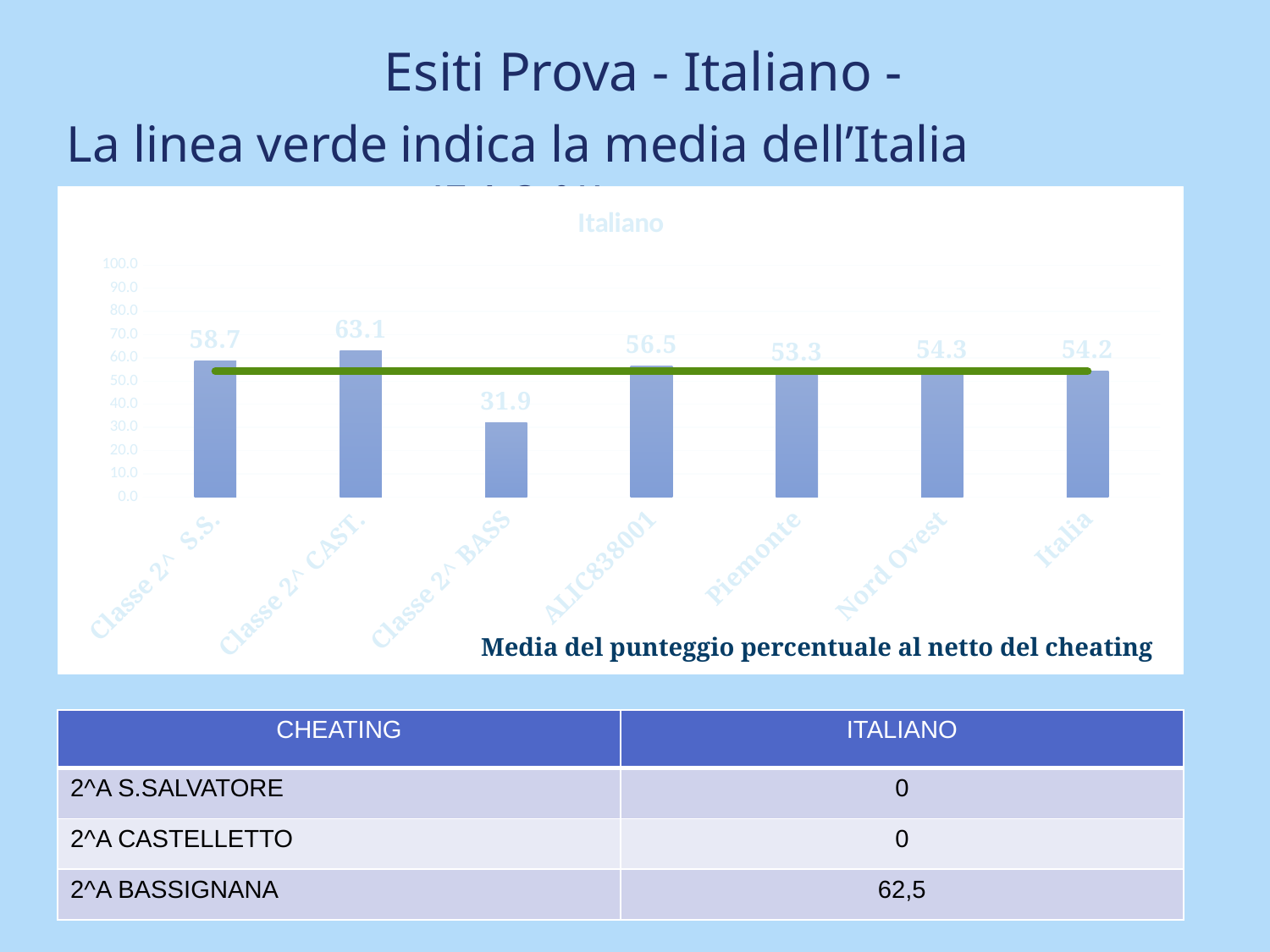
Which is larger in the Italiano chart, the value for Classe 2^ S.S. or the value for ALIC838001? Classe 2^ S.S. What is the value for Piemonte in the Italiano chart? 53.3 How many categories are shown in the Italiano chart? 7 What is the difference between the values for Classe 2^ S.S. and Italia in the Italiano chart? 4.5 Which category has the highest value in the Italiano chart? Classe 2^ CAST. Which category has the lowest value in the Italiano chart? Classe 2^ BASS What is the value for Classe 2^ BASS in the Italiano chart? 31.9 What is the value for Classe 2^ CAST. in the Italiano chart? 63.1 What is the difference between the values for Classe 2^ CAST. and Classe 2^ BASS in the Italiano chart? 31.2 What kind of chart is the Italiano chart? combination bar and line chart What is the value for Italia in the Italiano chart? 54.2 According to the slide, what does the green line in the chart indicate? la media dell'Italia